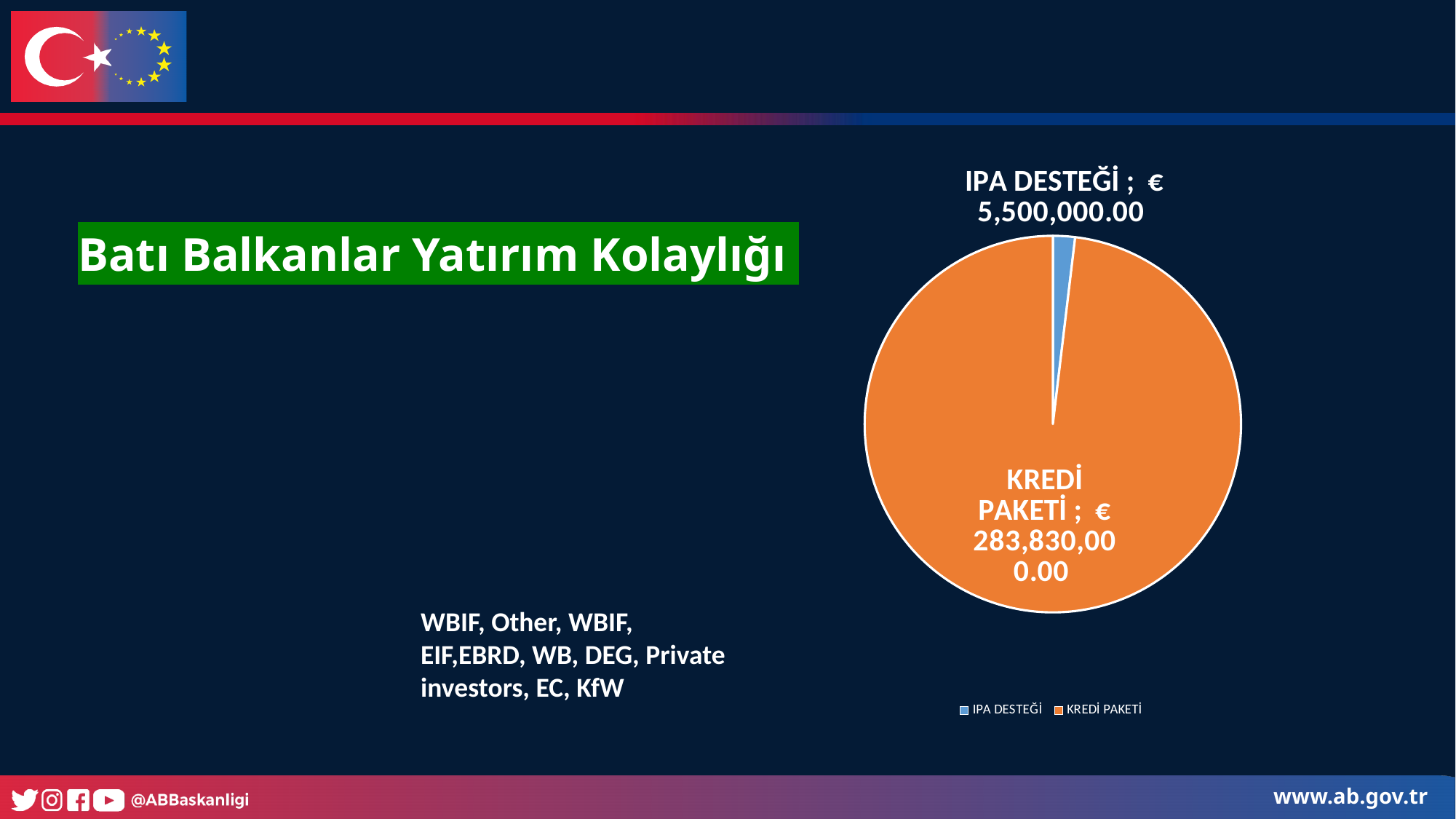
What is the total of the two slices in the pie chart? € 289,330,000.00 Which is larger in the pie chart, IPA DESTEĞİ or KREDİ PAKETİ? KREDİ PAKETİ What is the difference between the KREDİ PAKETİ value and the IPA DESTEĞİ value in the pie chart? € 278,330,000.00 What colour is the KREDİ PAKETİ slice in the pie chart? orange Which slice of the pie chart is the largest? KREDİ PAKETİ What is the value of the IPA DESTEĞİ slice in the pie chart? € 5,500,000.00 What kind of chart is shown on the slide? pie chart Which slice of the pie chart is the smallest? IPA DESTEĞİ What is the value of the KREDİ PAKETİ slice in the pie chart? € 283,830,000.00 How many entries does the legend of the pie chart list? 2 How many slices does the pie chart have? 2